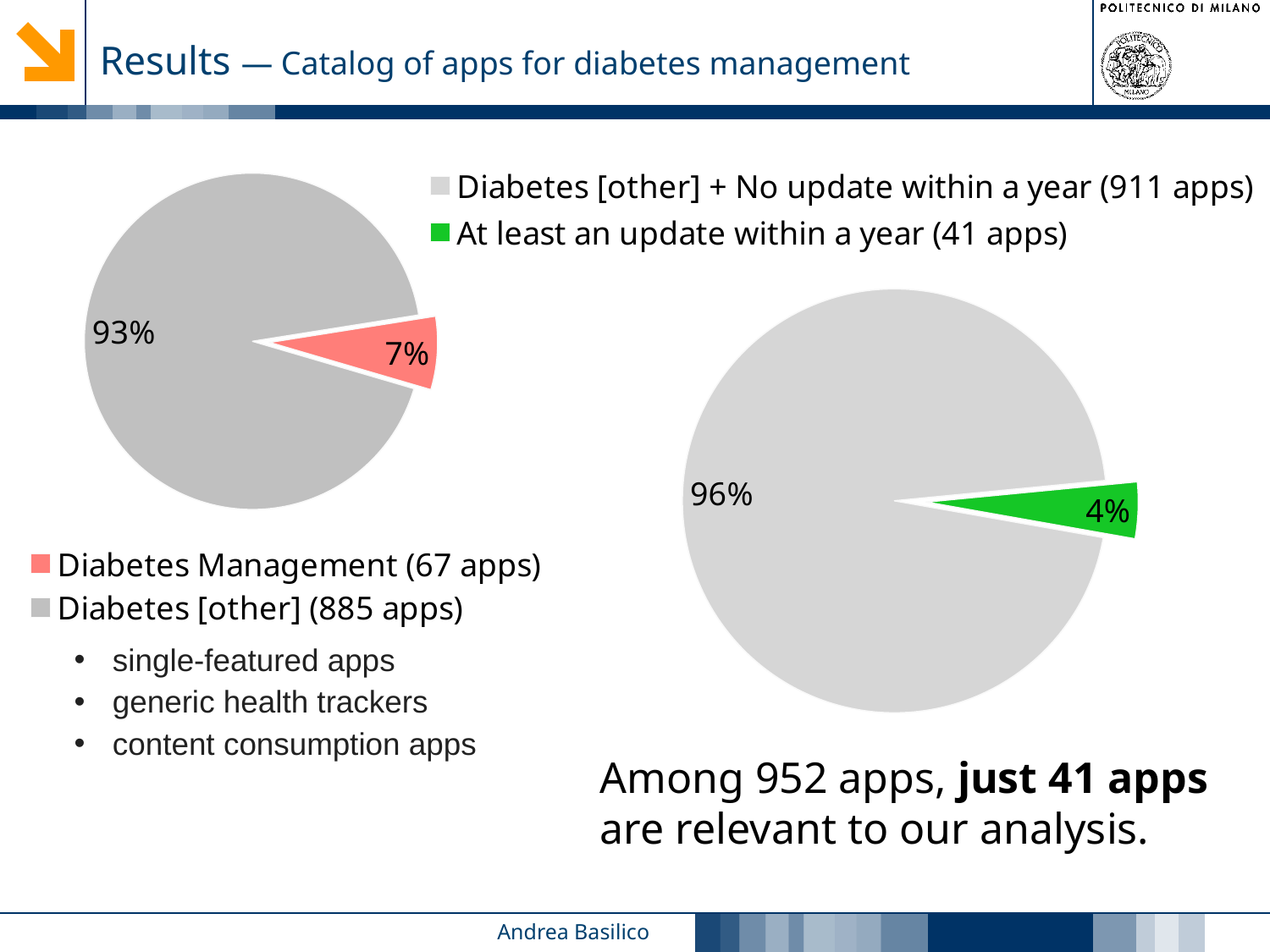
In the left pie chart, what share is labelled for Diabetes Management? 7% In the left pie chart, how many apps does the legend give for Diabetes [other]? 885 apps In the left pie chart, which slice is the largest? Diabetes [other] In the right pie chart, which slice is the smallest? At least an update within a year What kind of chart is the left chart on the slide? pie chart How many slices does the right pie chart have? 2 In the right pie chart, what share is labelled for 'Diabetes [other] + No update within a year'? 96% In the right pie chart, what share is labelled for 'At least an update within a year'? 4% In the right pie chart, what colour is the 'At least an update within a year' slice? green In the left pie chart, how many apps does the legend give for Diabetes Management? 67 apps In the right pie chart, how many apps does the legend give for 'At least an update within a year'? 41 apps